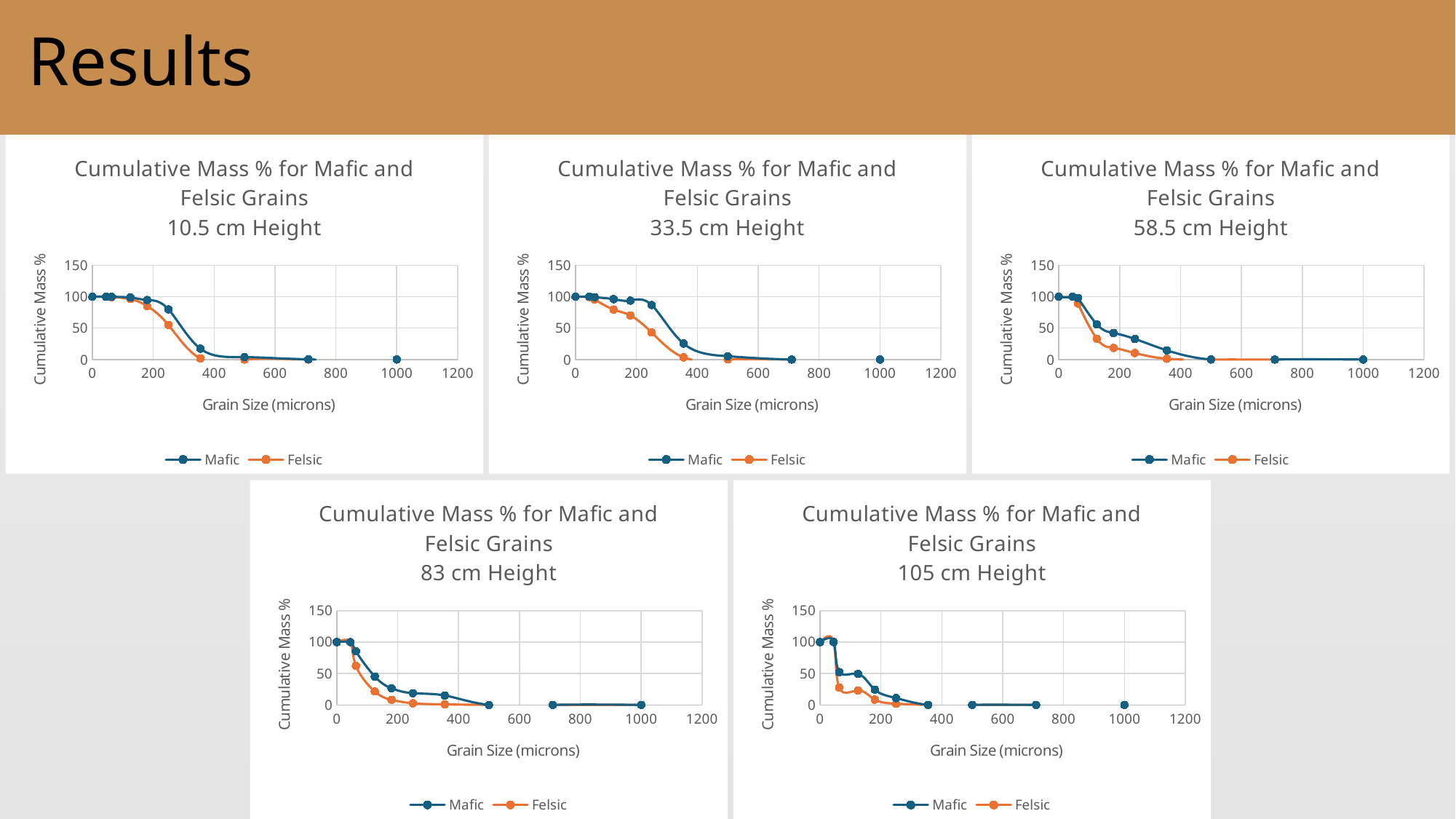
In the '10.5 cm Height' chart, do the Mafic values rise or fall as grain size increases? fall In the '33.5 cm Height' chart, is the Mafic value at 250 microns greater or less than 50? greater What are the two series named in the legend of the '58.5 cm Height' chart? Mafic and Felsic What kind of chart is the 'Cumulative Mass % for Mafic and Felsic Grains 10.5 cm Height' chart? line chart In the '58.5 cm Height' chart, which series has the larger value at 125 microns, Mafic or Felsic? Mafic How many charts are shown on the slide? 5 In the '10.5 cm Height' chart, what is the Mafic cumulative mass % at 0 microns? 100 In the '83 cm Height' chart, is the Felsic value at 125 microns greater or less than 50? less How many series does the legend of the '33.5 cm Height' chart list? 2 In the '105 cm Height' chart, which series has the larger value at 63 microns, Mafic or Felsic? Mafic In the '105 cm Height' chart, what is the Mafic cumulative mass % at 1000 microns? 0 In the '33.5 cm Height' chart, is the Felsic value at 355 microns greater or less than 50? less